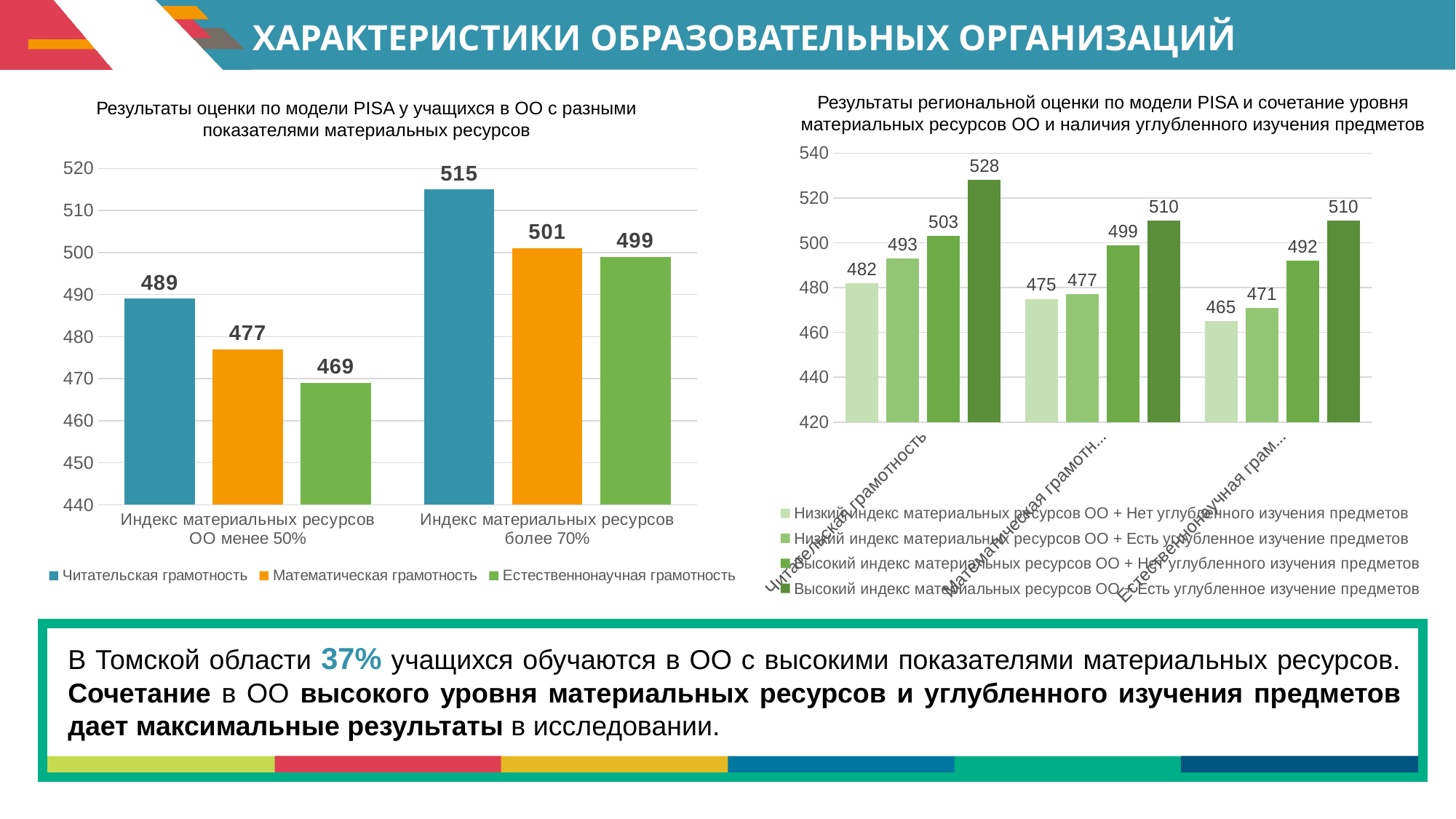
On the left chart, what is the value for Читательская грамотность in the category 'Индекс материальных ресурсов ОО менее 50%'? 489 On the left chart, what is the value for Естественнонаучная грамотность in the category 'Индекс материальных ресурсов более 70%'? 499 On the right chart, how many categories are shown on the x axis? 3 On the left chart, how many series does the legend list? 3 On the right chart, what is the difference between the highest and lowest values in Читательская грамотность? 46 On the left chart, what is the difference between Математическая грамотность in 'Индекс материальных ресурсов более 70%' and in 'Индекс материальных ресурсов ОО менее 50%'? 24 On the right chart, what is the lowest value shown for Естественнонаучная грамотность? 465 What kind of chart is the left chart? Bar chart On the left chart, which series has the highest value in the category 'Индекс материальных ресурсов более 70%'? Читательская грамотность On the right chart, what is the value for 'Высокий индекс материальных ресурсов ОО + Есть углубленное изучение предметов' in Читательская грамотность? 528 On the right chart, how many series does the legend list? 4 On the right chart, which is larger for Математическая грамотность: 'Низкий индекс материальных ресурсов ОО + Нет углубленного изучения предметов' or 'Высокий индекс материальных ресурсов ОО + Нет углубленного изучения предметов'? Высокий индекс материальных ресурсов ОО + Нет углубленного изучения предметов